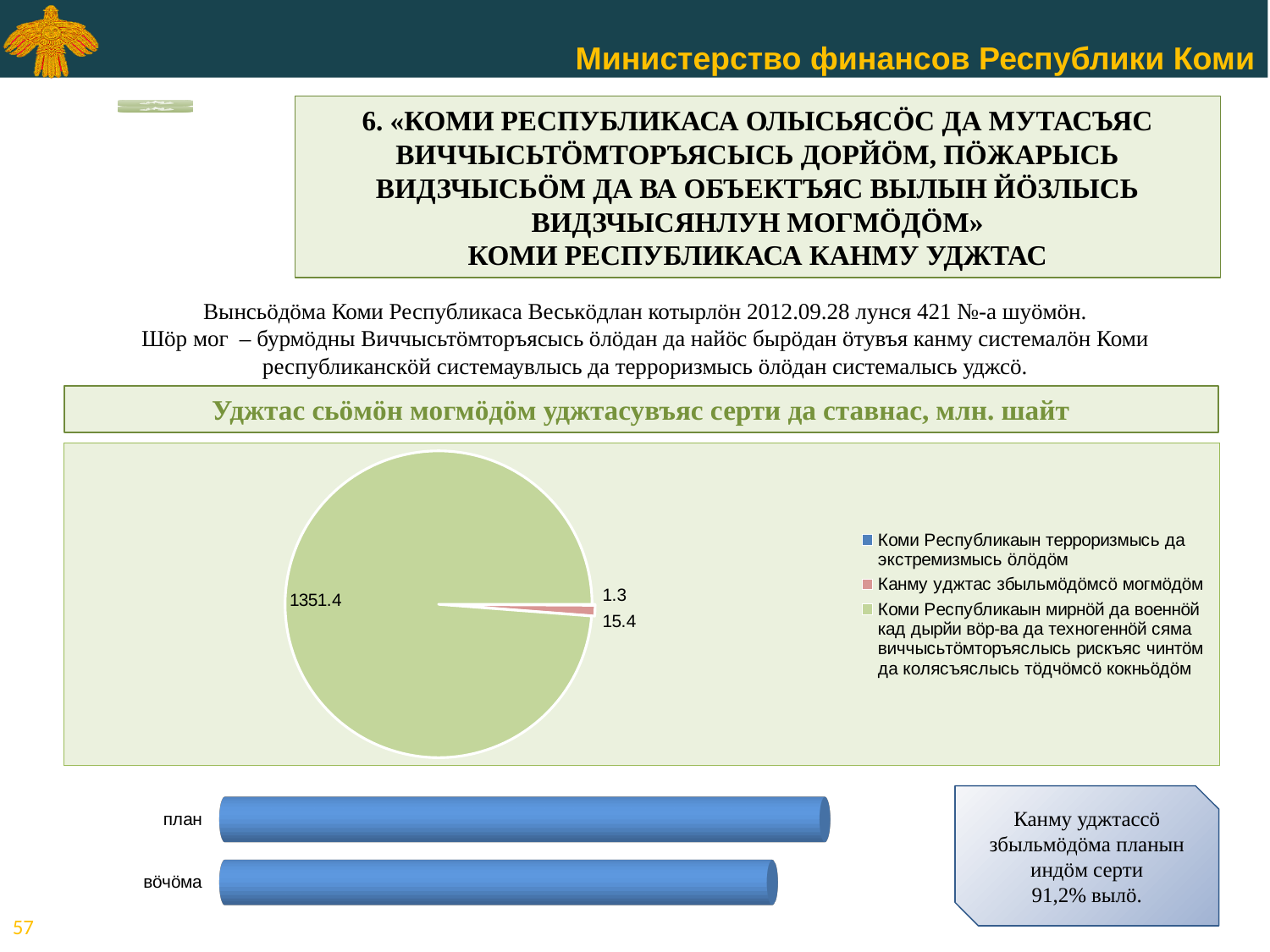
What kind of chart is the upper chart on the slide? pie chart On the pie chart, what is the value for 'Канму уджтас збыльмöдöмсö могмöдöм'? 15.4 How many entries does the legend of the pie chart list? 3 On the pie chart, what is the value for the slice 'Коми Республикаын мирнöй да военнöй кад дырйи вöр-ва да техногеннöй сяма виччысьтöмторъяслысь рискъяс чинтöм да колясъяслысь тöдчöмсö кокньöдöм'? 1351.4 On the lower bar chart, which bar is longer, 'план' or 'вöчöма'? план What kind of chart is the lower chart on the slide with the categories 'план' and 'вöчöма'? bar chart On the pie chart, which category has the smallest slice? Коми Республикаын терроризмысь да экстремизмысь öлöдöм On the pie chart, what is the value for 'Коми Республикаын терроризмысь да экстремизмысь öлöдöм'? 1.3 How many bars does the lower bar chart show? 2 On the pie chart, which category has the largest slice? Коми Республикаын мирнöй да военнöй кад дырйи вöр-ва да техногеннöй сяма виччысьтöмторъяслысь рискъяс чинтöм да колясъяслысь тöдчöмсö кокньöдöм On the pie chart, what is the total of the three slice values? 1368.1 On the pie chart, what is the difference between the value 15.4 and the value 1.3? 14.1